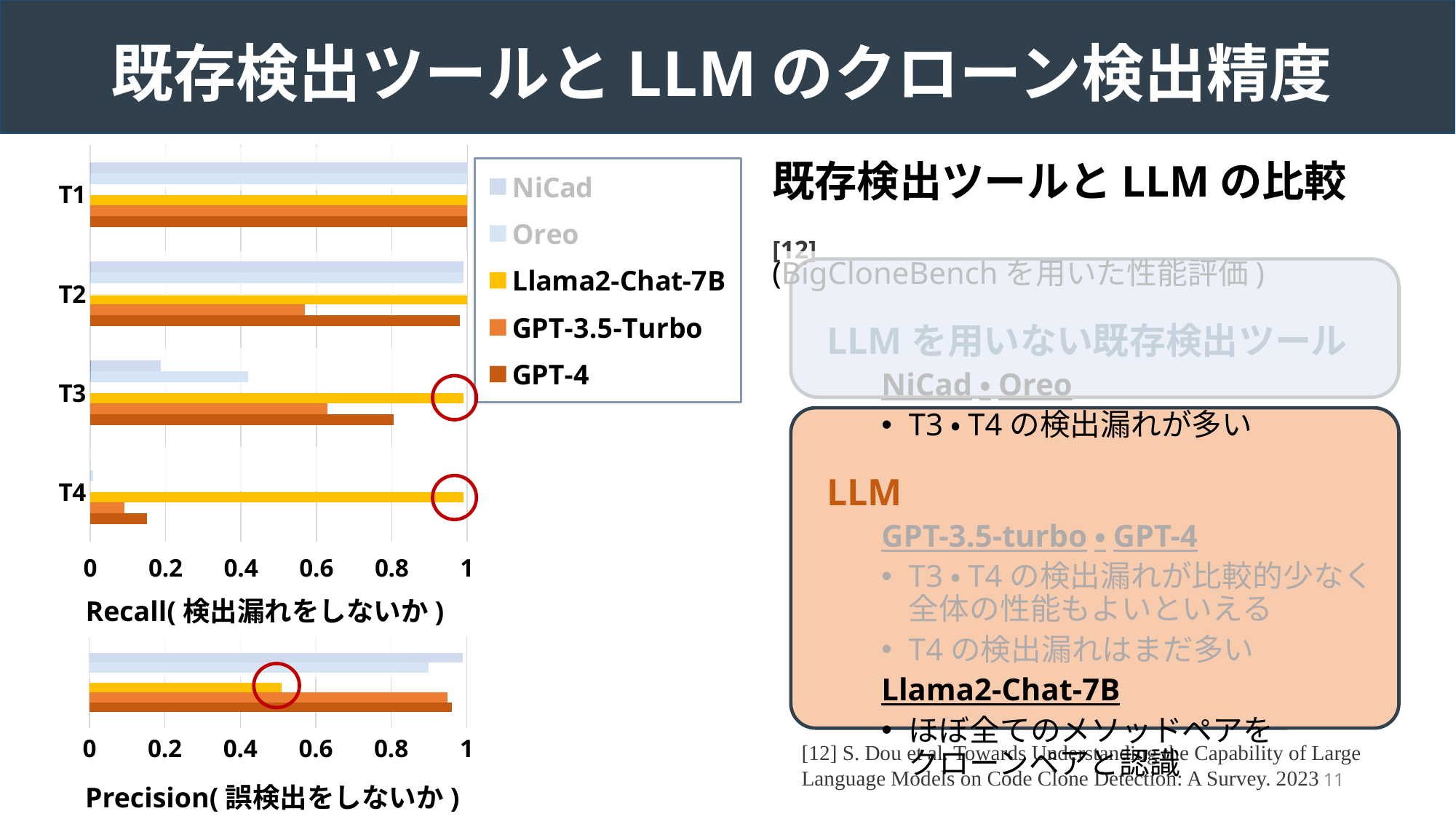
In the Precision chart at the bottom left, is the value for Llama2-Chat-7B greater or less than 0.6? less How many categories (T1–T4) are shown on the Recall chart? 4 In the Recall chart at T4, which is larger, GPT-4 or GPT-3.5-Turbo? GPT-4 In the Recall chart, do the GPT-4 values rise or fall going from T1 to T4? fall In the Recall chart, which series has the highest value at T3? Llama2-Chat-7B How many series does the legend of the Recall chart list? 5 In the Precision chart, which is larger, NiCad or Llama2-Chat-7B? NiCad What is the third entry in the legend of the Recall chart? Llama2-Chat-7B In the Recall chart, is the value for GPT-4 at T4 greater or less than 0.2? less In the Recall chart, is the value for Llama2-Chat-7B at T4 greater or less than 0.8? greater What kind of chart is the Recall chart at the top left of the slide? bar chart